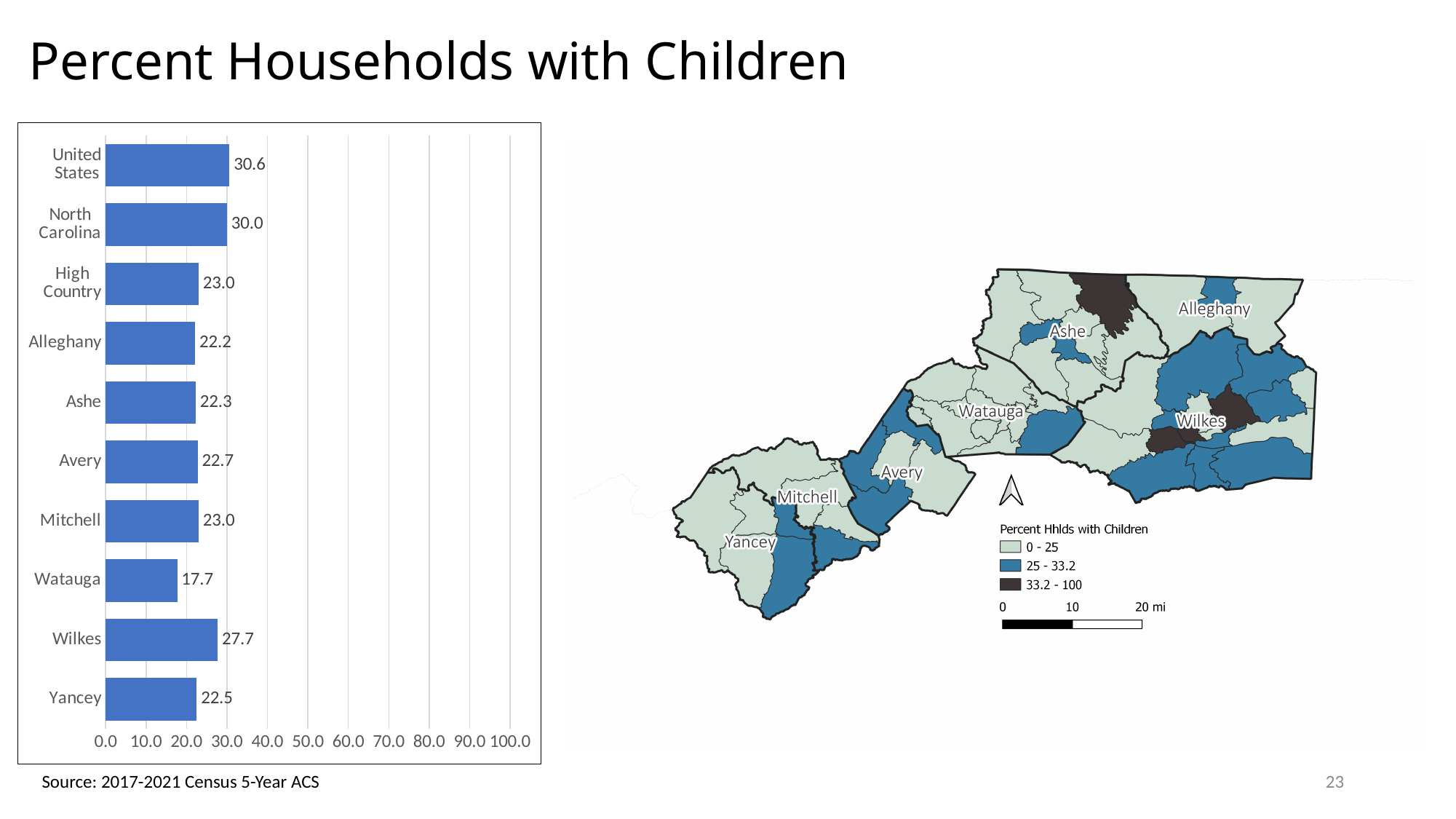
What is the value for Watauga in the bar chart? 17.7 Which category has the highest value in the bar chart? United States How many categories are shown in the bar chart? 10 What is the difference between the United States value and the Watauga value in the bar chart? 12.9 What is the value for North Carolina in the bar chart? 30.0 What is the value for Wilkes in the bar chart? 27.7 Which category has the lowest value in the bar chart? Watauga What is the highest value on the x axis of the bar chart? 100.0 What is the value for High Country in the bar chart? 23.0 Is the value for Avery in the bar chart greater or less than 30.0? less Which has a larger value in the bar chart, Wilkes or Yancey? Wilkes What kind of chart is shown on the left of the slide? bar chart